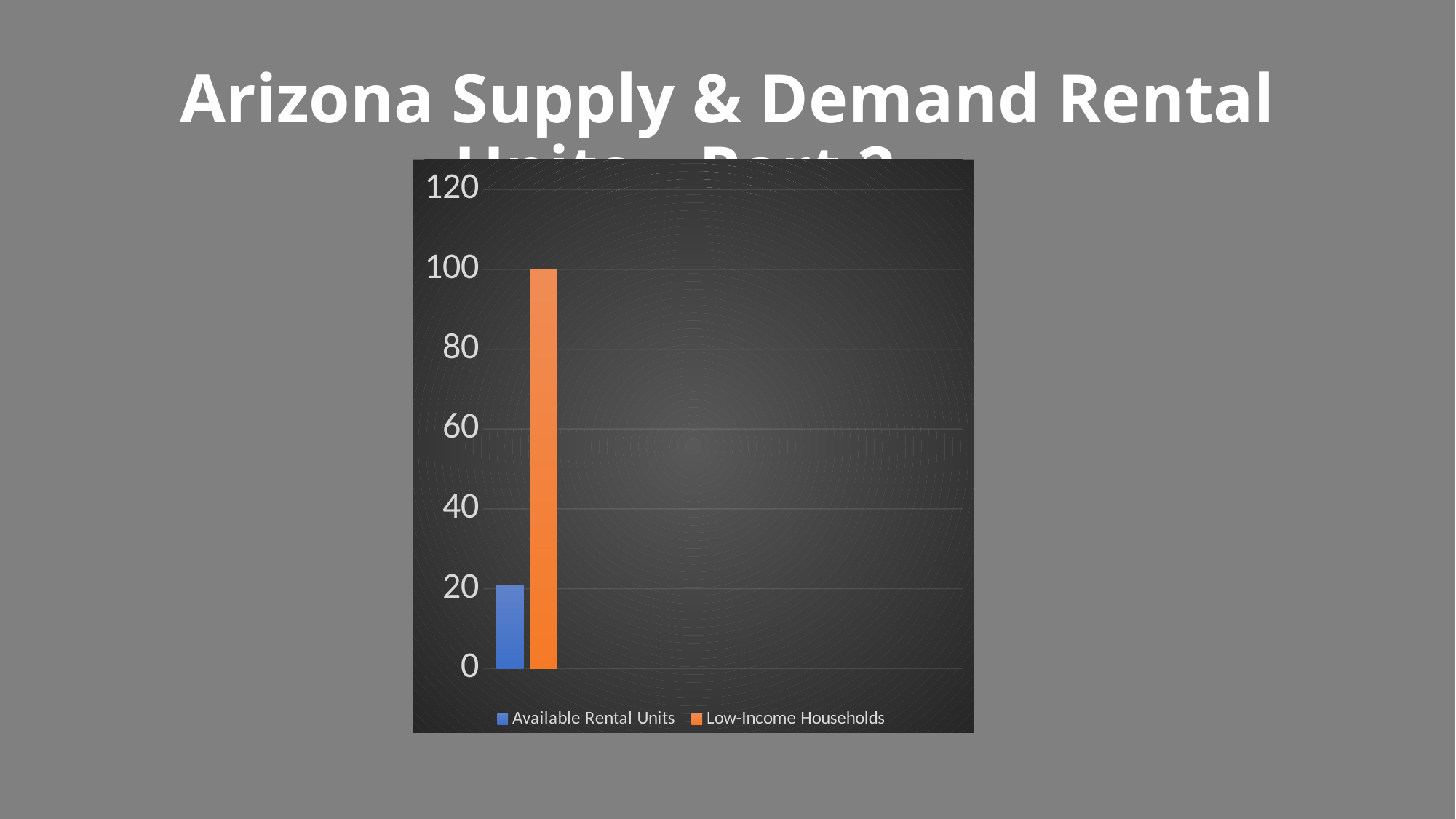
Which is larger, Available Rental Units or Low-Income Households? Low-Income Households What colour is the bar for Low-Income Households? orange How many series does the legend list? 2 How many bars are plotted on the chart? 2 What is the highest value shown on the vertical axis? 120 Is the value for Available Rental Units greater or less than 40? less Which series has the lowest value? Available Rental Units What kind of chart is shown on the slide? bar chart What is the value for Low-Income Households? 100 Is the value for Low-Income Households greater or less than 80? greater Which series has the highest value? Low-Income Households